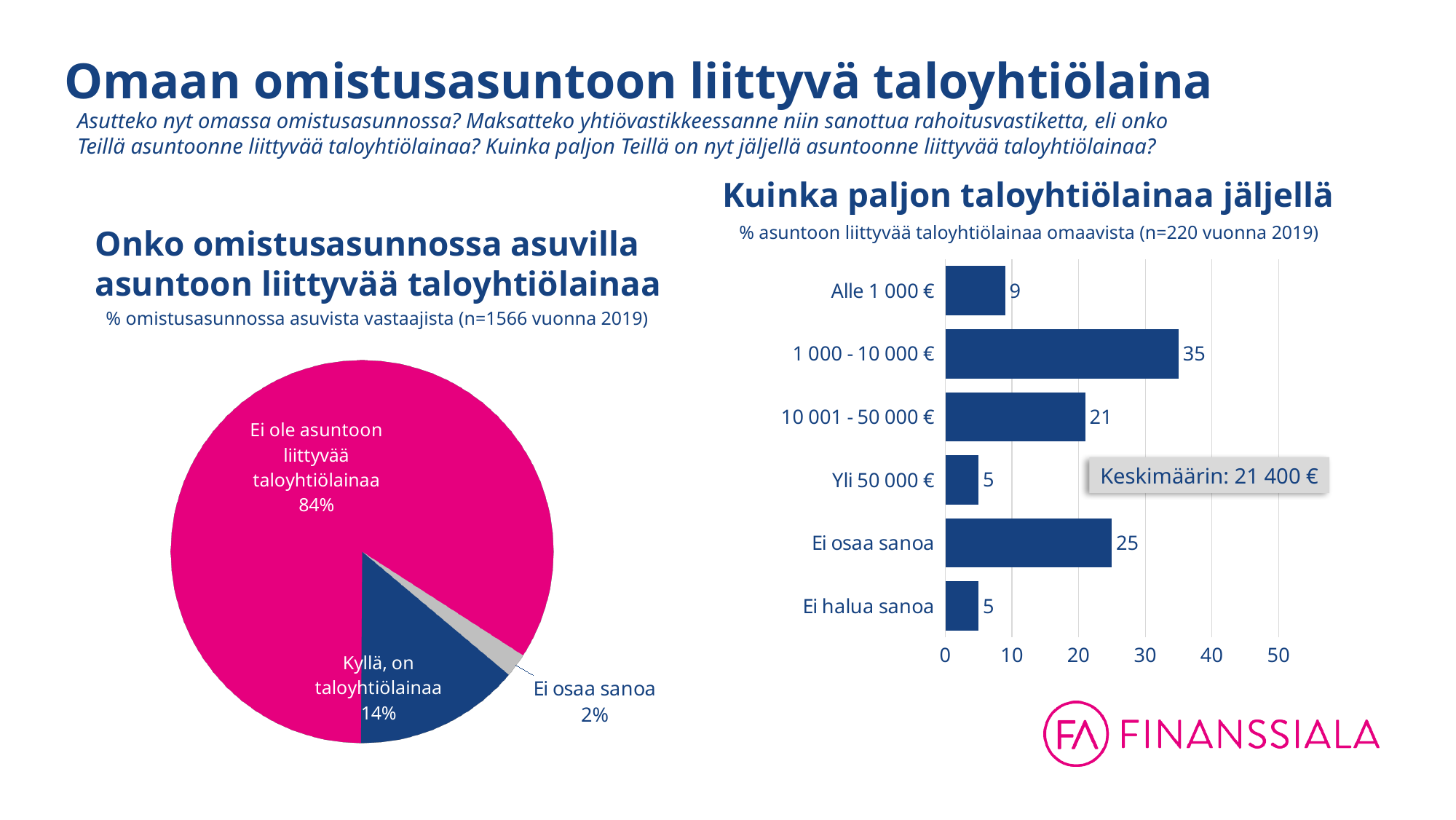
In the bar chart 'Kuinka paljon taloyhtiölainaa jäljellä', which category has the highest value? 1 000 - 10 000 € In the pie chart 'Onko omistusasunnossa asuvilla asuntoon liittyvää taloyhtiölainaa', which slice is the smallest? Ei osaa sanoa In the bar chart 'Kuinka paljon taloyhtiölainaa jäljellä', what is the value for 'Ei osaa sanoa'? 25 In the bar chart 'Kuinka paljon taloyhtiölainaa jäljellä', what is the value for '1 000 - 10 000 €'? 35 In the pie chart 'Onko omistusasunnossa asuvilla asuntoon liittyvää taloyhtiölainaa', how many slices are there? 3 In the bar chart 'Kuinka paljon taloyhtiölainaa jäljellä', what average amount is shown in the callout box? 21 400 € In the bar chart 'Kuinka paljon taloyhtiölainaa jäljellä', what is the difference between '1 000 - 10 000 €' and '10 001 - 50 000 €'? 14 In the bar chart 'Kuinka paljon taloyhtiölainaa jäljellä', which is larger: 'Alle 1 000 €' or 'Yli 50 000 €'? Alle 1 000 € In the bar chart 'Kuinka paljon taloyhtiölainaa jäljellä', how many categories are shown? 6 What kind of chart is the left chart 'Onko omistusasunnossa asuvilla asuntoon liittyvää taloyhtiölainaa'? Pie chart In the pie chart 'Onko omistusasunnossa asuvilla asuntoon liittyvää taloyhtiölainaa', what is the value for 'Kyllä, on taloyhtiölainaa'? 14% In the pie chart 'Onko omistusasunnossa asuvilla asuntoon liittyvää taloyhtiölainaa', what share is 'Ei ole asuntoon liittyvää taloyhtiölainaa'? 84%